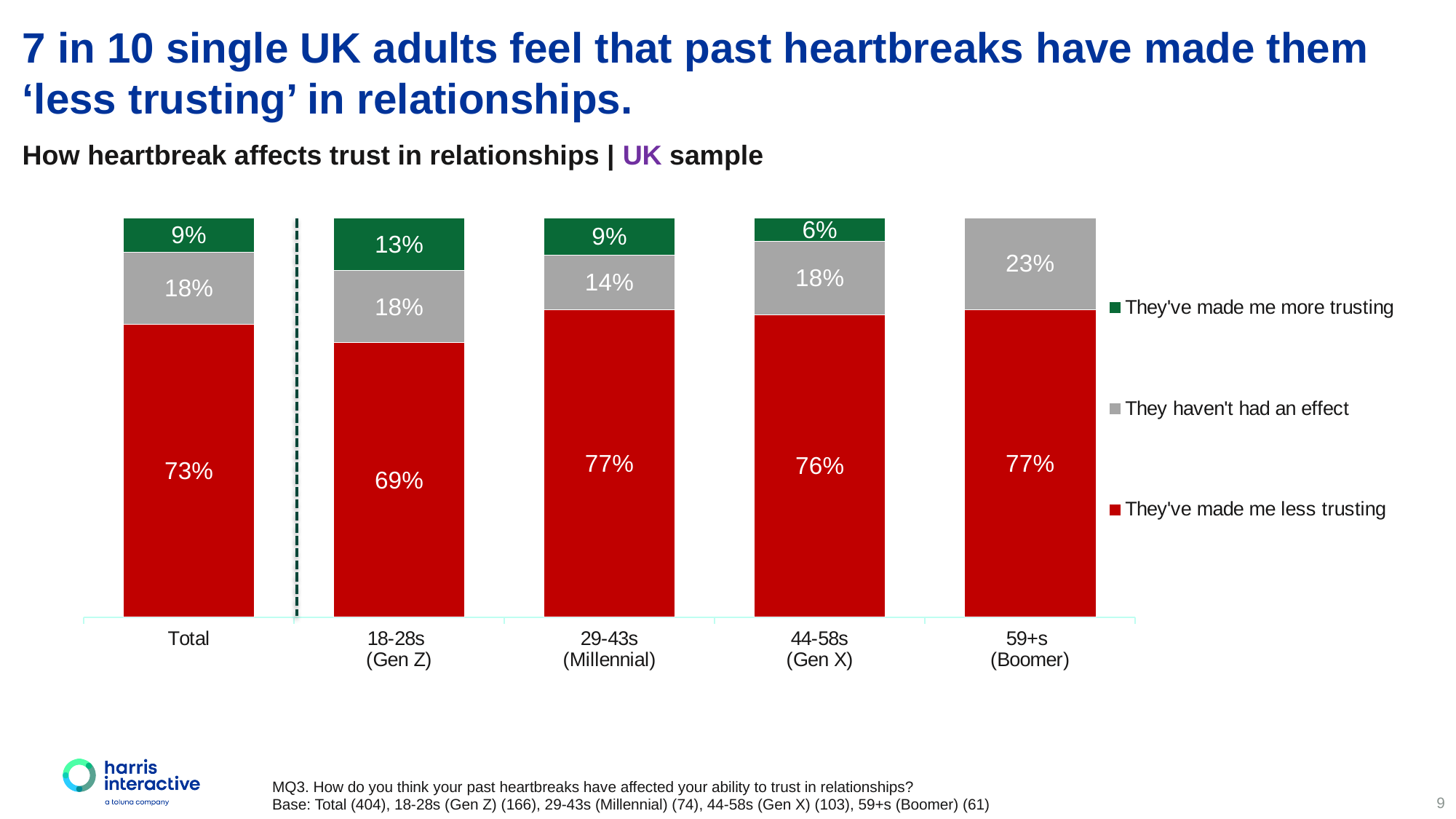
What percentage of 18-28s (Gen Z) say heartbreaks have made them more trusting? 13% How many categories are shown on the x axis of the chart? 5 What percentage of 59+s (Boomer) say heartbreaks haven't had an effect? 23% Is the 'haven't had an effect' share larger for 29-43s (Millennial) or 44-58s (Gen X)? 44-58s (Gen X) What type of chart is used on this slide? Stacked bar chart Which group has the highest share saying heartbreaks haven't had an effect? 59+s (Boomer) Which age group has the lowest share saying heartbreaks have made them less trusting? 18-28s (Gen Z) What percentage of the Total sample say past heartbreaks have made them less trusting? 73% Which group has the highest share saying heartbreaks have made them more trusting? 18-28s (Gen Z) How many percentage points higher is the 'less trusting' share for the Total sample than for 18-28s (Gen Z)? 4 percentage points What percentage of 44-58s (Gen X) say heartbreaks have made them less trusting? 76% How many series does the chart legend list? 3